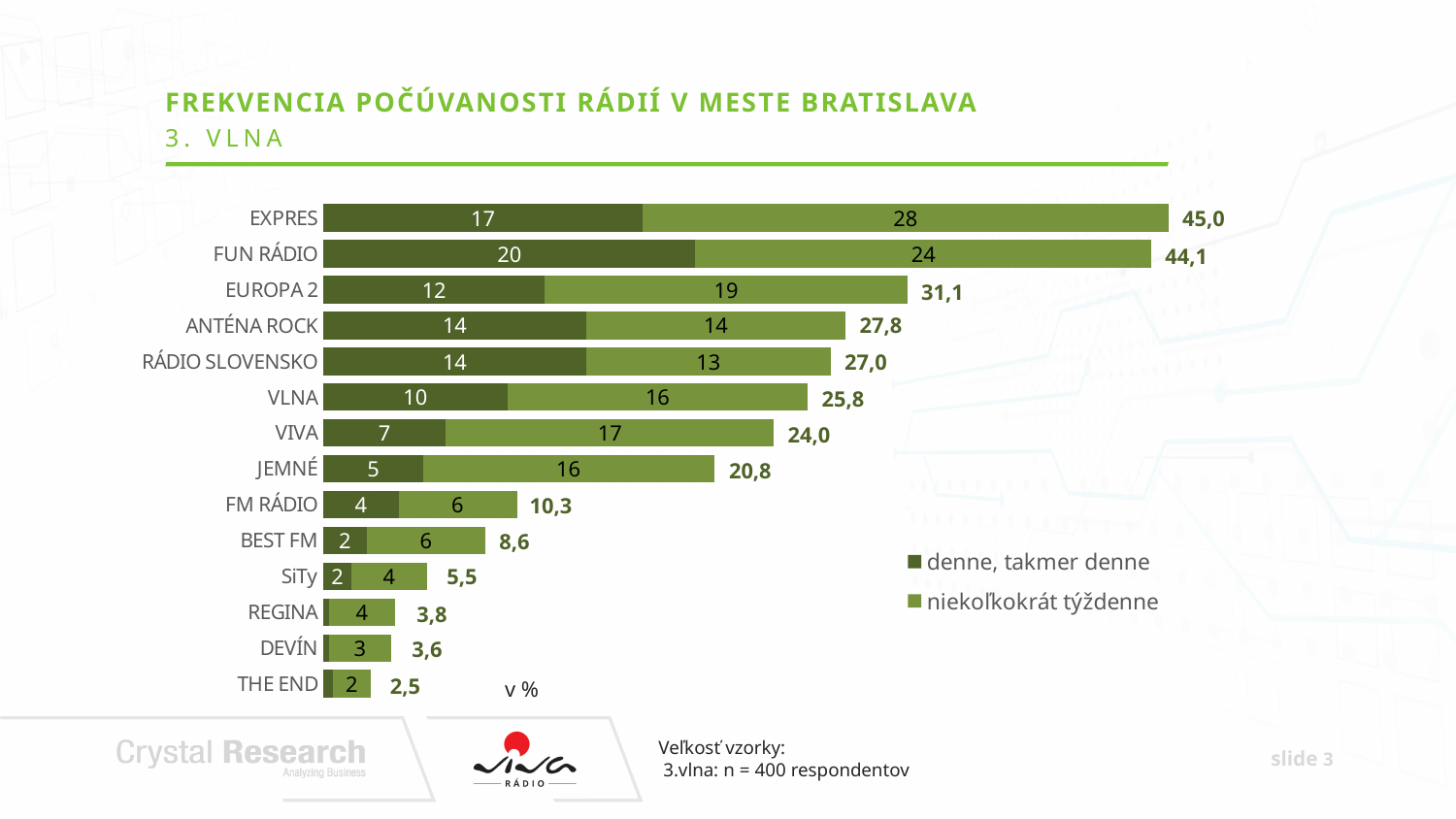
How many series does the legend list? 2 What is the title of the chart on the slide? FREKVENCIA POČÚVANOSTI RÁDIÍ V MESTE BRATISLAVA What is the 'denne, takmer denne' value for FUN RÁDIO? 20 What is the total value shown for JEMNÉ? 20,8 How many radio stations are listed in the chart? 14 What is the total value shown for EXPRES? 45,0 What is the difference between the total values of EXPRES and FUN RÁDIO? 0,9 What kind of chart is shown on the slide? Stacked bar chart What is the 'niekoľkokrát týždenne' value for EUROPA 2? 19 Which has a larger total value, VLNA or VIVA? VLNA Which radio station has the highest total value? EXPRES Which radio station has the lowest total value? THE END